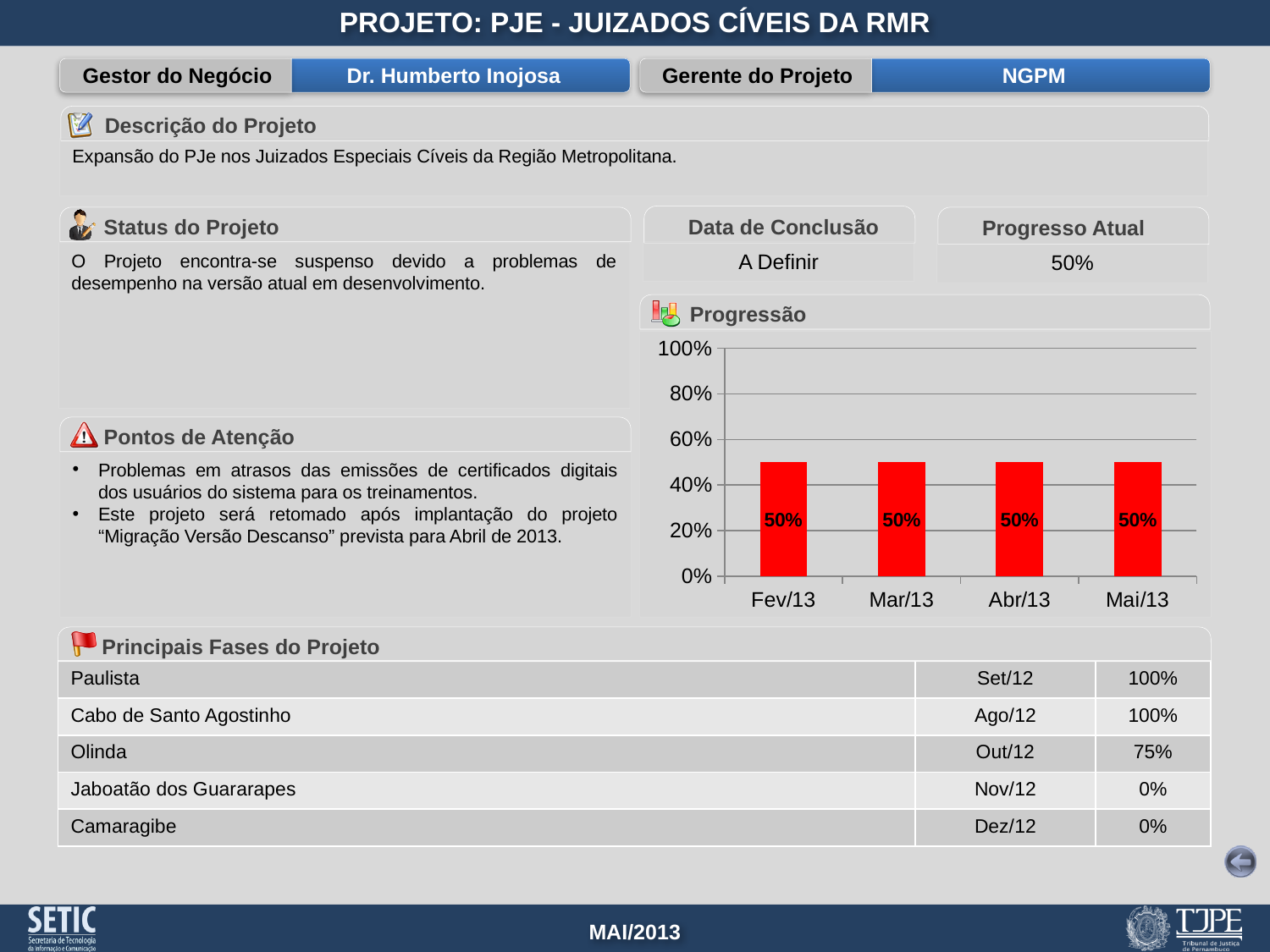
What is the value for Fev/13 in the Progressão chart? 50% Do the values in the Progressão chart rise, fall, or stay flat from Fev/13 to Mai/13? stay flat Is the value for Mai/13 in the Progressão chart greater or less than 60%? less What colour are the bars in the Progressão chart? red What is the difference between the values for Fev/13 and Mai/13 in the Progressão chart? 0% Is the value for Abr/13 in the Progressão chart greater or less than 40%? greater What is the title of the bar chart on the slide? Progressão How many months are plotted on the x axis of the Progressão chart? 4 What is the value for Abr/13 in the Progressão chart? 50% What kind of chart is the Progressão chart? bar chart What is the value for Mar/13 in the Progressão chart? 50% What is the value for Mai/13 in the Progressão chart? 50%